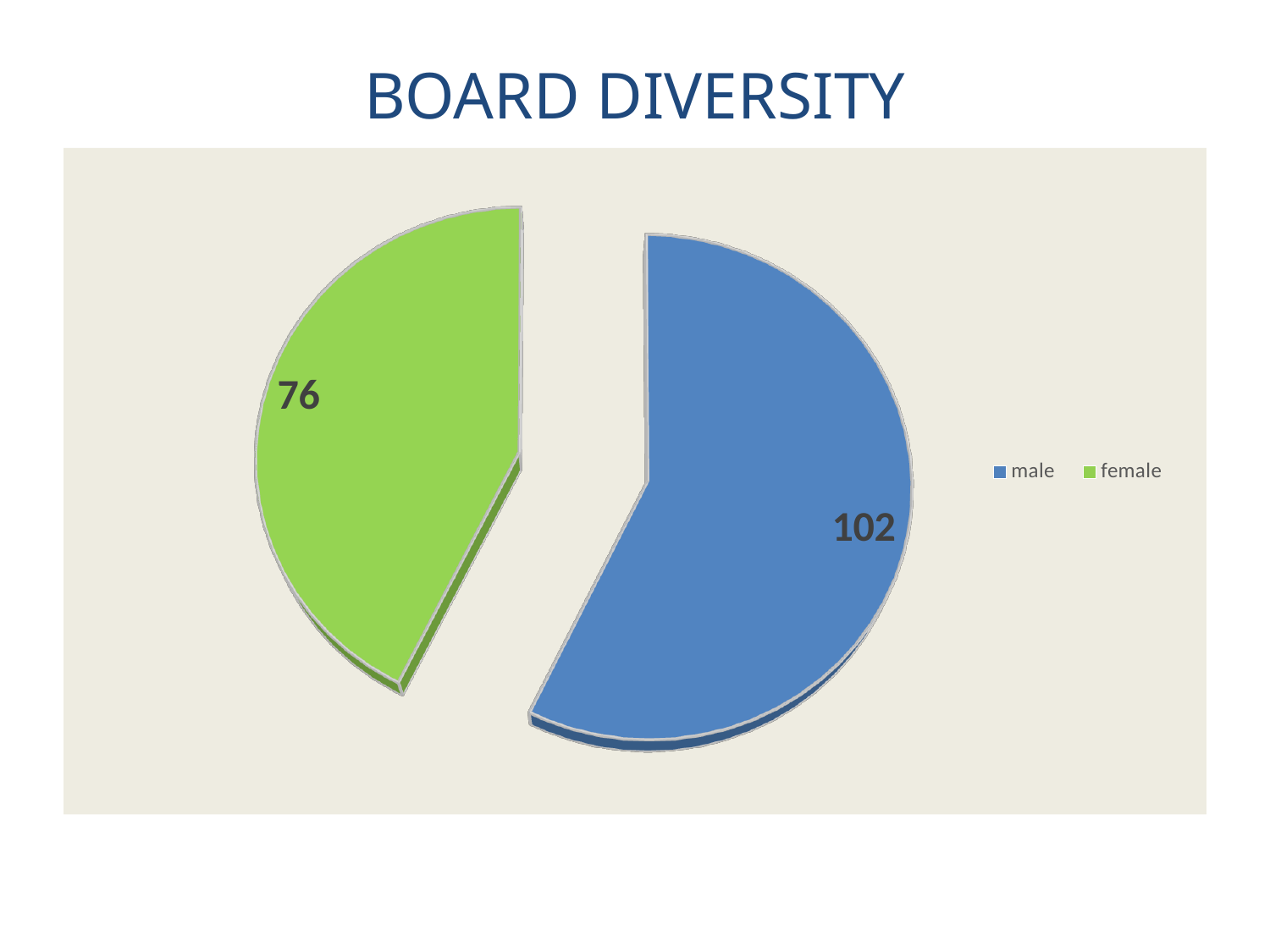
What is the value for female? 76 How many entries does the legend list? 2 What colour is the female slice? green How many slices does the pie chart have? 2 Which category has the largest slice? male Which is larger, the value for male or the value for female? male What is the title of the chart? BOARD DIVERSITY What is the total of the two slices? 178 Which category has the smallest slice? female What is the value for male? 102 What kind of chart is shown on the slide? pie chart What is the difference between the male and female values? 26